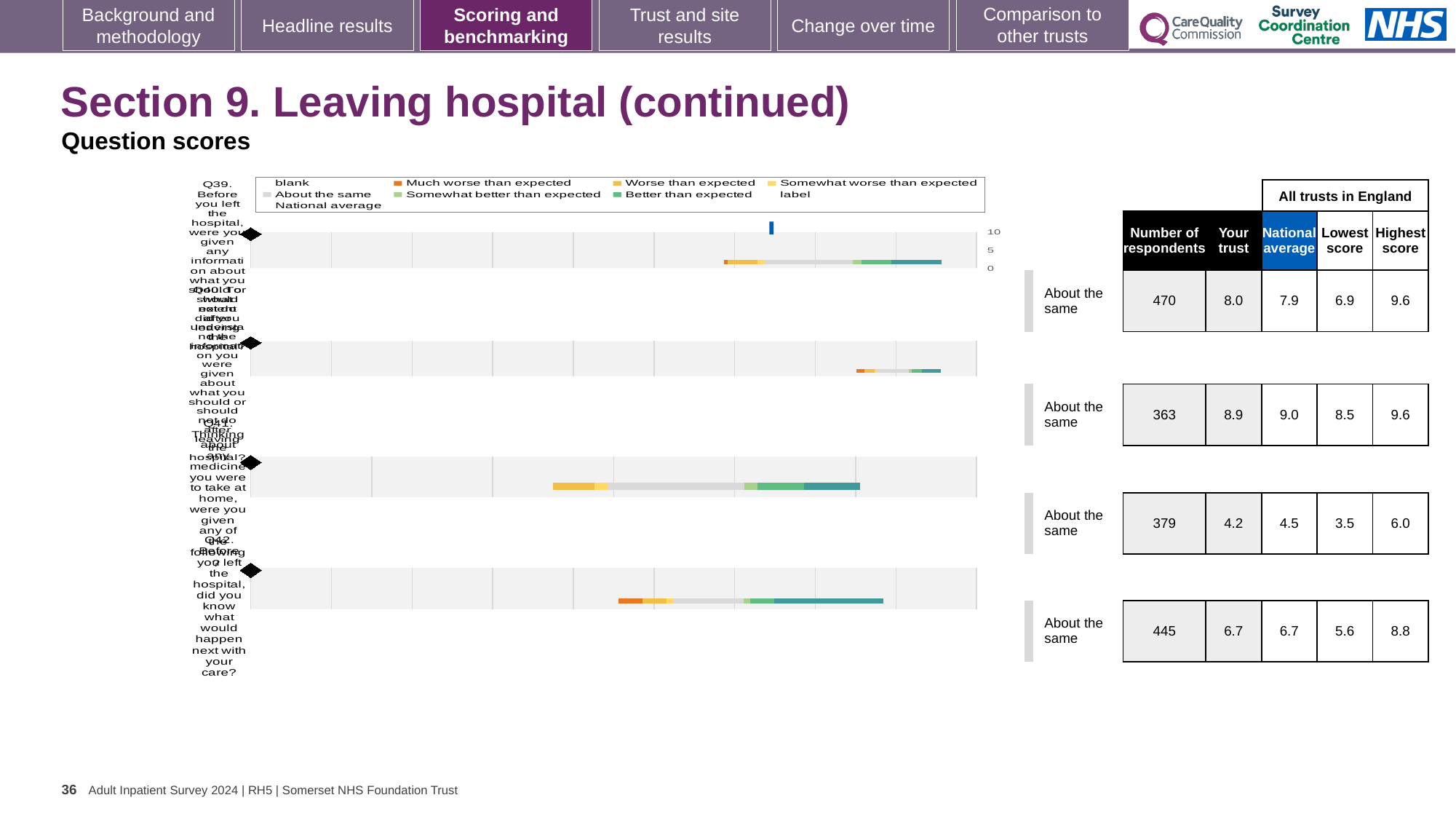
In the table, what is the 'Lowest score' for the last row (Q42)? 5.6 In the table, what is the 'Your trust' score for the first row (Q39)? 8.0 What benchmark label is shown next to each of the four questions? About the same Which row of the table has the highest number of respondents? the first row (Q39), 470 In the table, what is the 'National average' for the last row (Q42)? 6.7 In the second row of the table (Q40), which is larger: the 'Your trust' score or the 'National average'? National average What kind of chart is shown on the slide? bar chart What colour does the legend use for 'Much worse than expected'? orange Which row of the table has the lowest 'Your trust' score? the third row (Q41), 4.2 In the third row of the table (Q41), what is the difference between the highest score and the lowest score? 2.5 In the first row of the table (Q39), how much higher is the 'Your trust' score than the 'National average'? 0.1 How many questions (bars) are plotted in the chart? 4